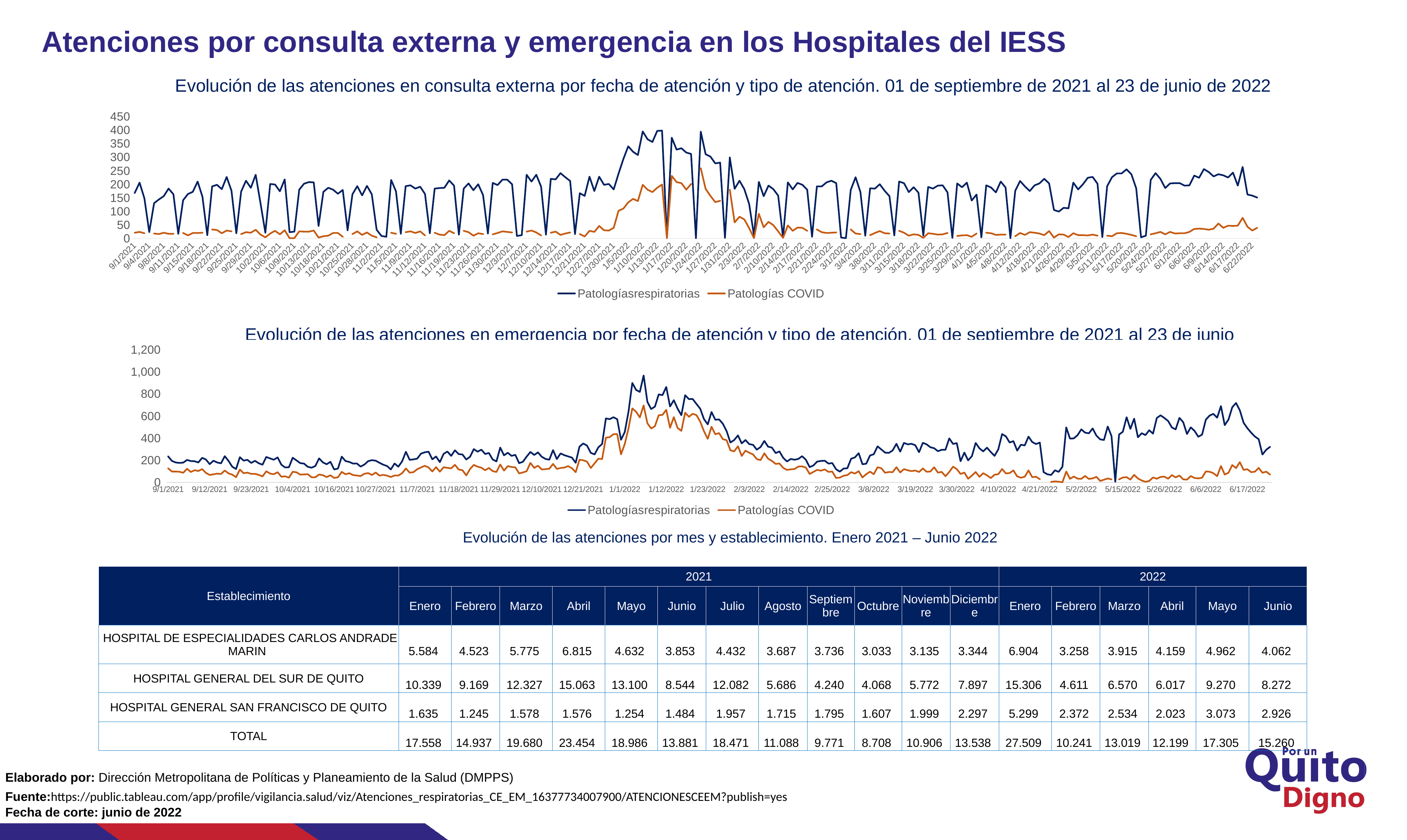
In the bottom chart (emergencia), do the values of Patologías respiratorias rise or fall between 1/12/2022 and 2/25/2022? Fall How many series does the legend of the top chart (consulta externa) list? 2 In the top chart (consulta externa), is the highest value of Patologías COVID greater or less than 200? greater How many series does the legend of the bottom chart (emergencia) list? 2 What kind of chart is the bottom chart, 'Evolución de las atenciones en emergencia por fecha de atención y tipo de atención'? Line chart What kind of chart is the top chart, 'Evolución de las atenciones en consulta externa por fecha de atención y tipo de atención'? Line chart In the bottom chart (emergencia), is the peak value of Patologías respiratorias in early January 2022 greater or less than 800? greater In the bottom chart (emergencia), which colour is used for the Patologías COVID line? Orange In the top chart (consulta externa), which series reaches higher values overall, Patologías respiratorias or Patologías COVID? Patologías respiratorias In the top chart (consulta externa), is the peak value of Patologías respiratorias in January 2022 greater or less than 350? greater What is the highest value shown on the vertical axis of the top chart (consulta externa)? 450